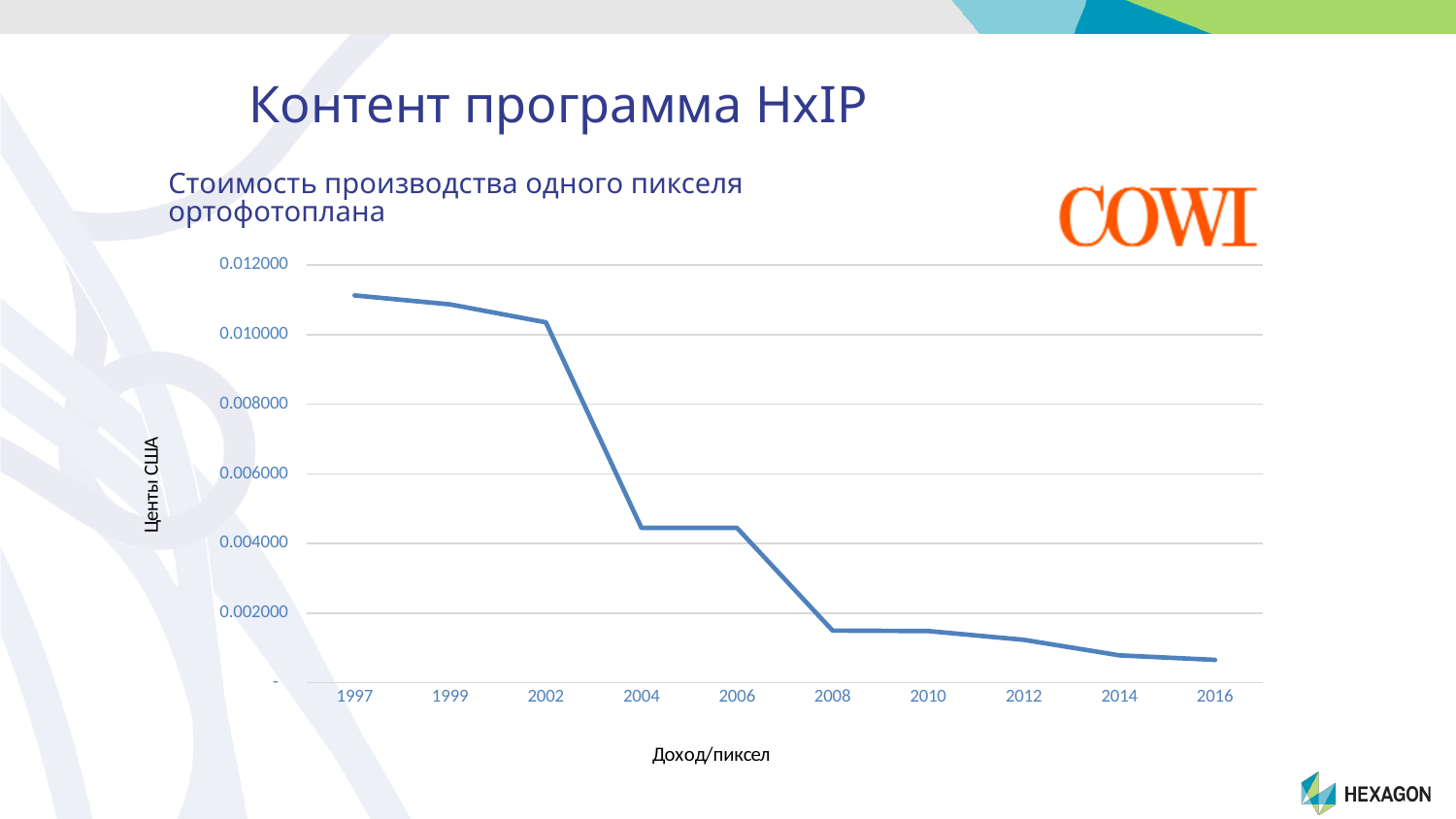
What is the label on the y axis? Центы США Is the value for 1997 greater or less than 0.010000? greater Which year has the lowest value? 2016 Do the values rise or fall from 1997 to 2016? fall Is the value for 2008 greater or less than 0.002000? less Is the value for 2004 greater or less than 0.006000? less How many years are labelled on the x axis? 10 What kind of chart is shown on the slide? line chart Which is larger, the value for 2002 or the value for 2006? 2002 What is the title of the chart? Стоимость производства одного пикселя ортофотоплана Which year has the highest value? 1997